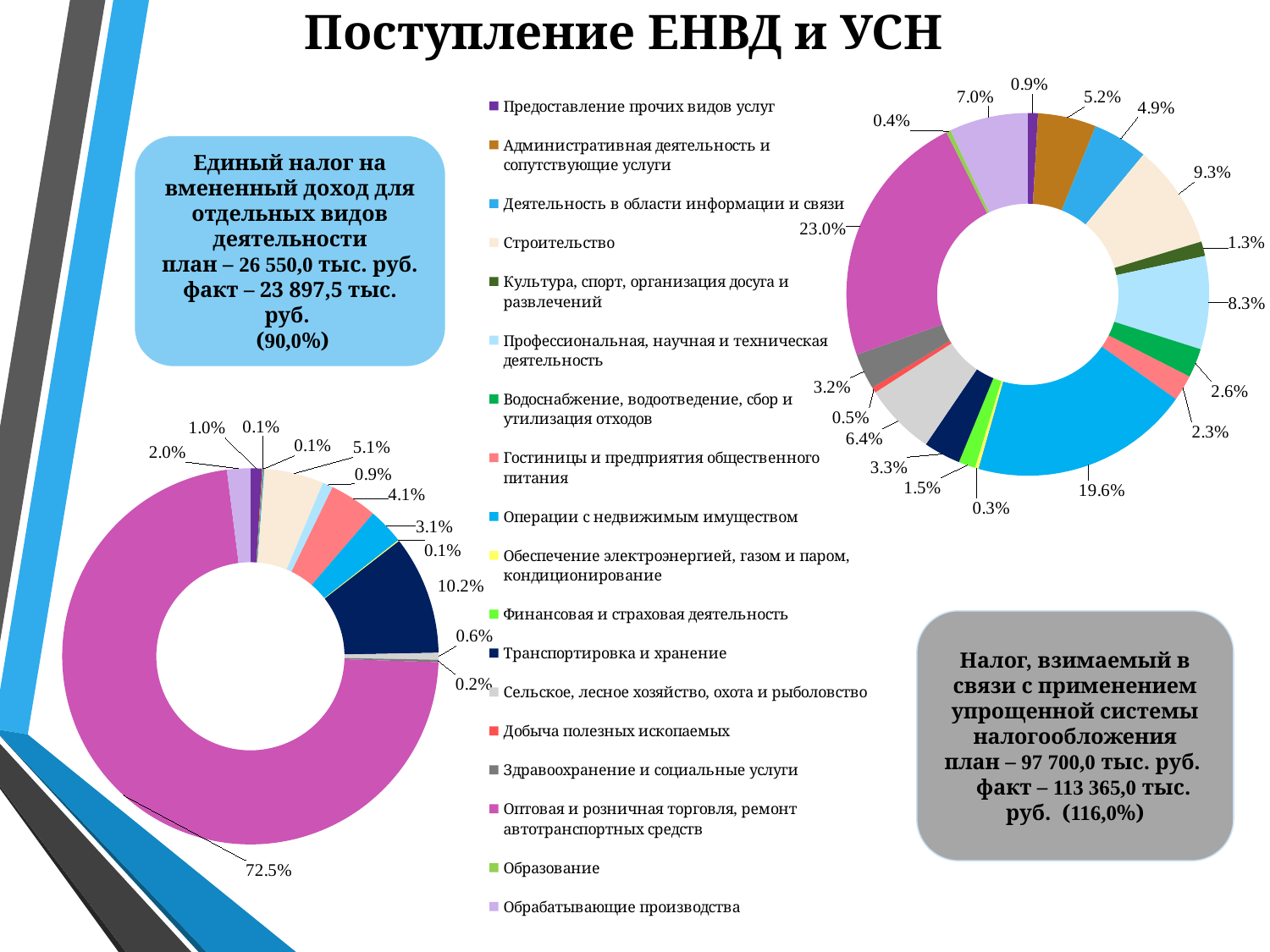
In the right chart (УСН), what is the share of Операции с недвижимым имуществом? 19.6% In the right chart (УСН), what is the share of Строительство? 9.3% In the right chart (УСН), what is the difference between the shares of Оптовая и розничная торговля and Операции с недвижимым имуществом? 3.4% How many categories does the shared legend list? 18 In the left chart (ЕНВД), what is the share of the largest slice? 72.5% Which chart shows a larger share for Обрабатывающие производства, the left (ЕНВД) or the right (УСН)? Right (УСН), 7.0% In the right chart (УСН), what is the share of Сельское, лесное хозяйство, охота и рыболовство? 6.4% What is the title of the slide? Поступление ЕНВД и УСН What kind of chart is used on the left side of the slide? Doughnut (pie) chart In the left chart (ЕНВД), which category has the largest share? Оптовая и розничная торговля, ремонт автотранспортных средств In the left chart (ЕНВД), what is the share of Транспортировка и хранение? 10.2% In the right chart (УСН), what is the share of Оптовая и розничная торговля, ремонт автотранспортных средств? 23.0%